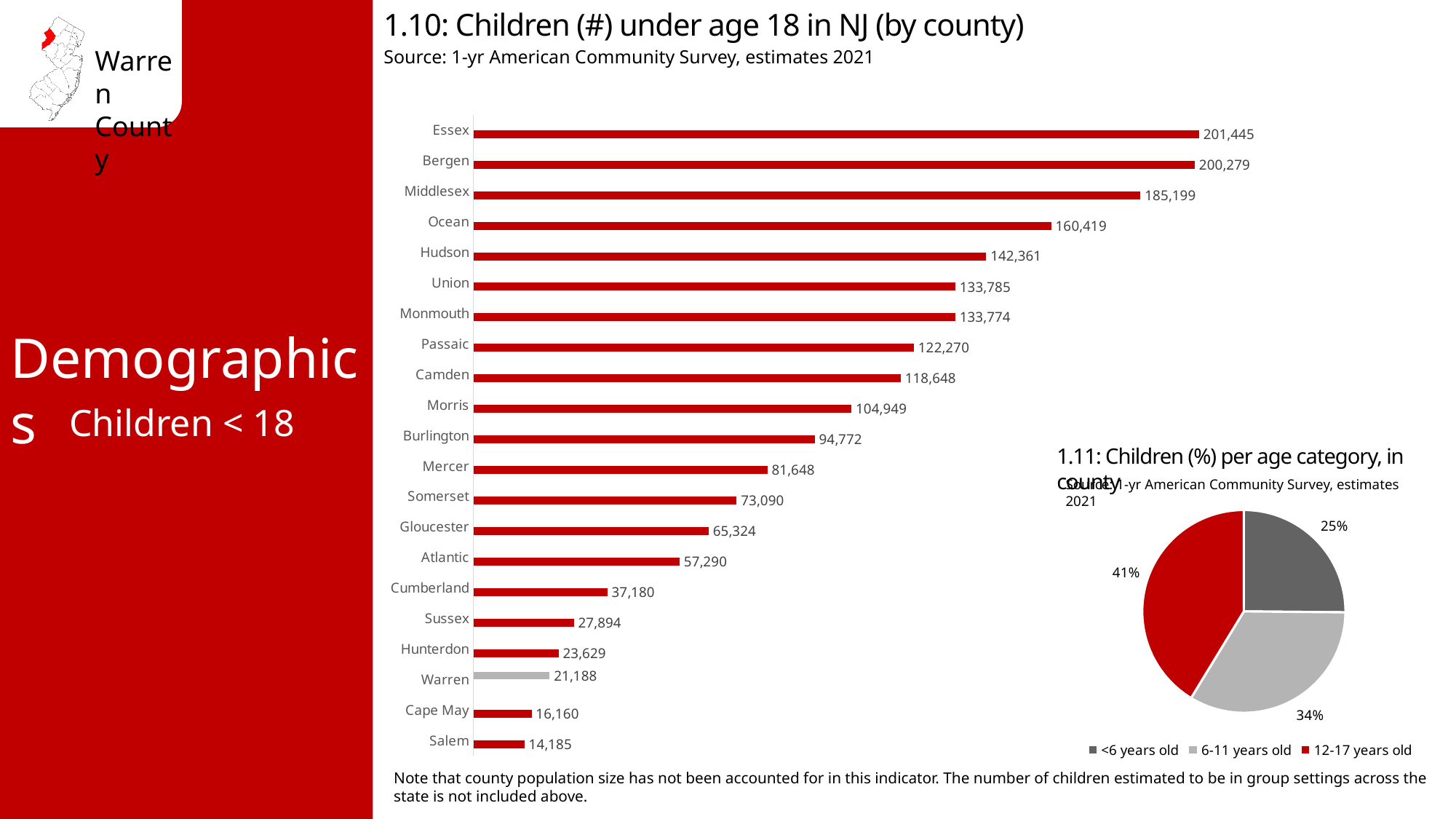
How many categories does the legend of chart 1.11 list? 3 What kind of chart is chart 1.10? Bar chart In chart 1.11, what percentage of children are under 6 years old? 25% In chart 1.10, which county has the lowest number of children under age 18? Salem In chart 1.11, what percentage of children are 12-17 years old? 41% In chart 1.10, which county has the highest number of children under age 18? Essex In chart 1.10, which county has more children under 18, Somerset or Gloucester? Somerset In chart 1.11, which age category has the smallest share? <6 years old In chart 1.10, how many children under age 18 are in Warren County? 21,188 In chart 1.10, what is the difference between the number of children in Warren and Cape May? 5,028 In chart 1.10, how many counties are shown? 21 In chart 1.10, how many children under age 18 are in Hudson County? 142,361